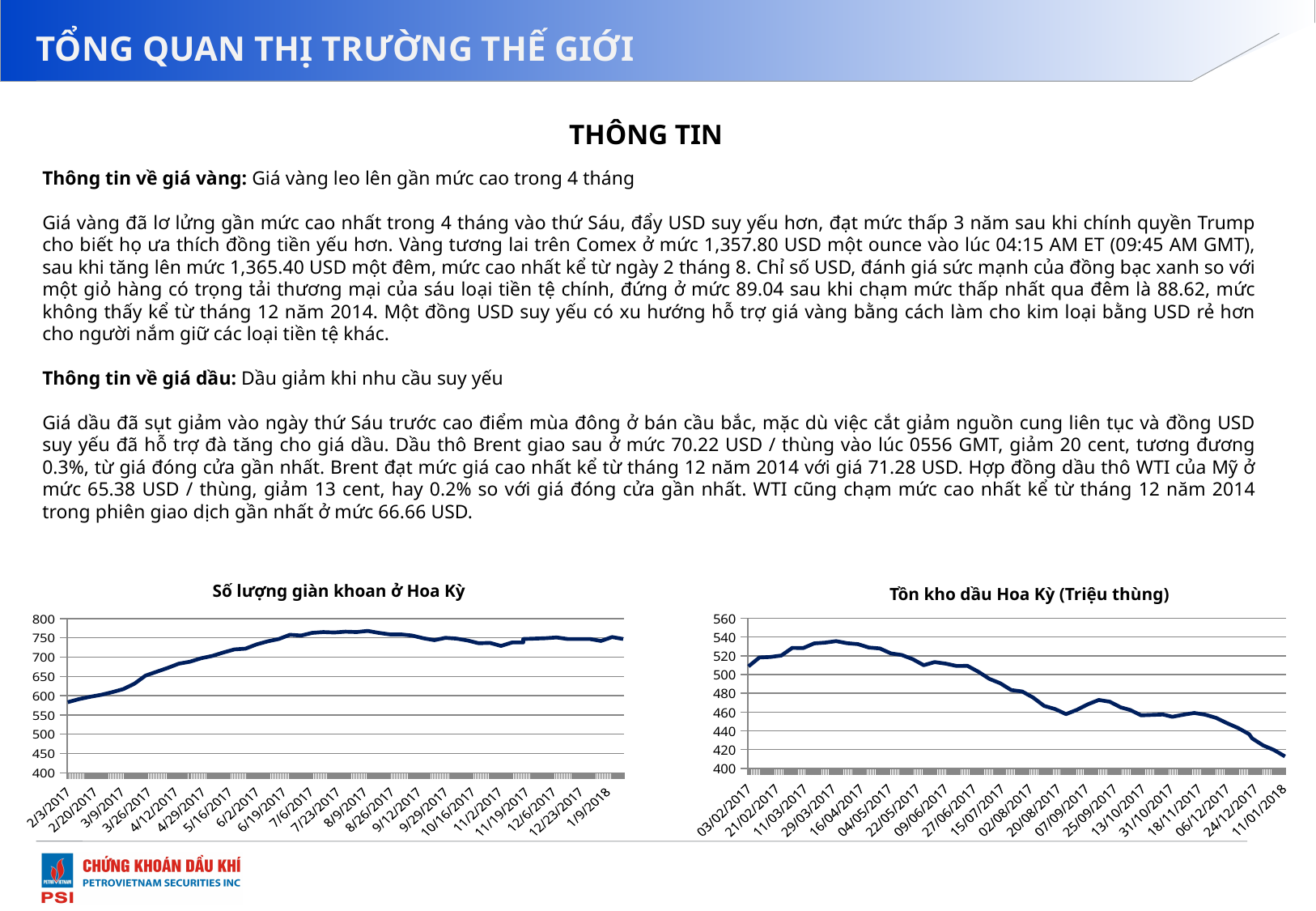
In the chart "Số lượng giàn khoan ở Hoa Kỳ", which is larger, the value for 2/3/2017 or the value for 1/9/2018? 1/9/2018 In the chart "Tồn kho dầu Hoa Kỳ (Triệu thùng)", is the value for 03/02/2017 greater or less than 500? greater What kind of chart is the chart titled "Tồn kho dầu Hoa Kỳ (Triệu thùng)"? line chart In the chart "Tồn kho dầu Hoa Kỳ (Triệu thùng)", is the value for 11/01/2018 greater or less than 440? less In the chart "Số lượng giàn khoan ở Hoa Kỳ", is the value for 2/3/2017 greater or less than 650? less In the chart "Tồn kho dầu Hoa Kỳ (Triệu thùng)", do the values generally rise or fall from 03/02/2017 to 11/01/2018? fall In the chart "Tồn kho dầu Hoa Kỳ (Triệu thùng)", which date has the lowest value? 11/01/2018 What kind of chart is the chart titled "Số lượng giàn khoan ở Hoa Kỳ"? line chart In the chart "Tồn kho dầu Hoa Kỳ (Triệu thùng)", which is larger, the value for 03/02/2017 or the value for 11/01/2018? 03/02/2017 What is the title of the chart on the right side of the slide? Tồn kho dầu Hoa Kỳ (Triệu thùng) In the chart "Số lượng giàn khoan ở Hoa Kỳ", do the values generally rise or fall from 2/3/2017 to 1/9/2018? rise